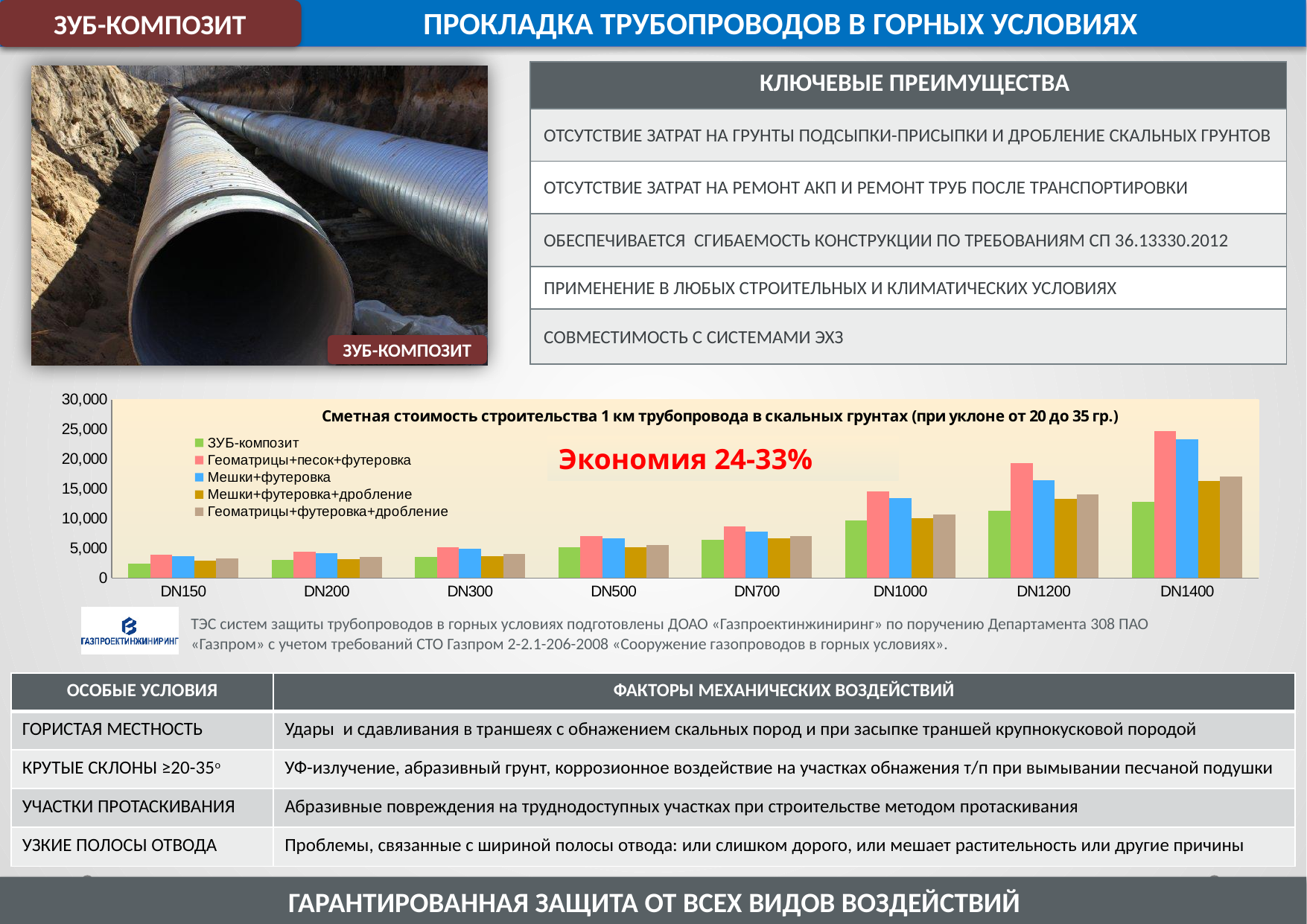
Which series has the lowest bar at DN1400? ЗУБ-композит What is the title of the chart? Сметная стоимость строительства 1 км трубопровода в скальных грунтах (при уклоне от 20 до 35 гр.) How many pipe diameter categories are shown on the x axis of the chart? 8 At DN1400, which is larger: the value for Геоматрицы+песок+футеровка or the value for ЗУБ-композит? Геоматрицы+песок+футеровка How many series does the chart legend list? 5 Is the value for ЗУБ-композит at DN1400 greater or less than 10,000? greater What kind of chart is shown on the slide? bar chart For which category is the Геоматрицы+песок+футеровка bar the highest? DN1400 Which series is shown in green in the chart? ЗУБ-композит Is the value for ЗУБ-композит at DN150 greater or less than 5,000? less Do the values for ЗУБ-композит rise or fall from DN150 to DN1400? rise Is the value for Геоматрицы+песок+футеровка at DN1400 greater or less than 20,000? greater